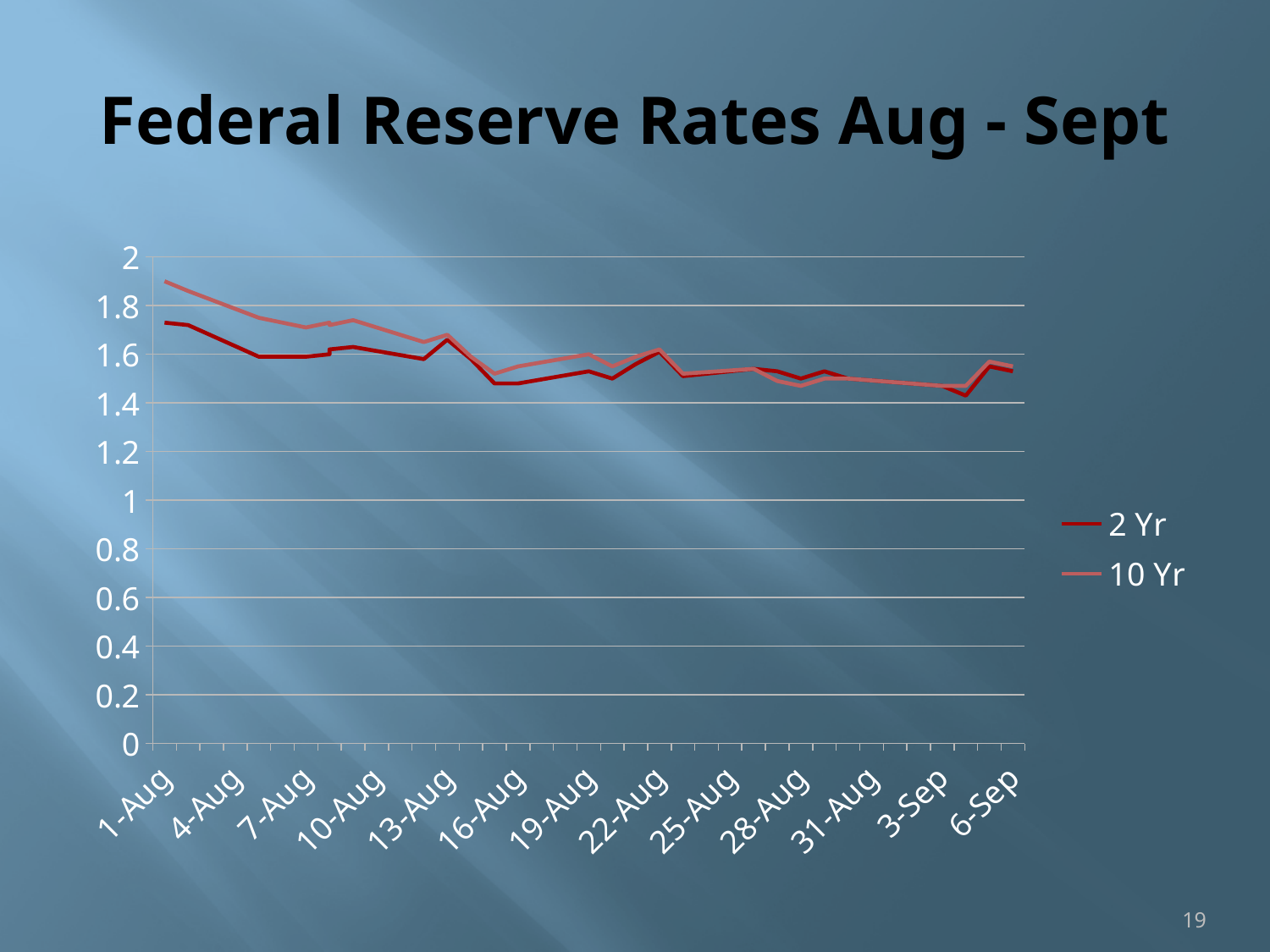
What are the two series named in the legend? 2 Yr and 10 Yr How many series does the legend list? 2 At 1-Aug, which series has the higher value, 2 Yr or 10 Yr? 10 Yr Is the 2 Yr value at 1-Aug greater or less than 1.8? less Overall, do the 10 Yr values rise or fall from 1-Aug to 6-Sep? fall How many date labels are shown on the x axis? 13 Is the 2 Yr value at 16-Aug greater or less than 1.6? less Overall, do the 2 Yr values rise or fall from 1-Aug to 6-Sep? fall Is the 10 Yr value at 3-Sep greater or less than 1.6? less What kind of chart is shown on the slide? line chart What is the title of the chart? Federal Reserve Rates Aug - Sept